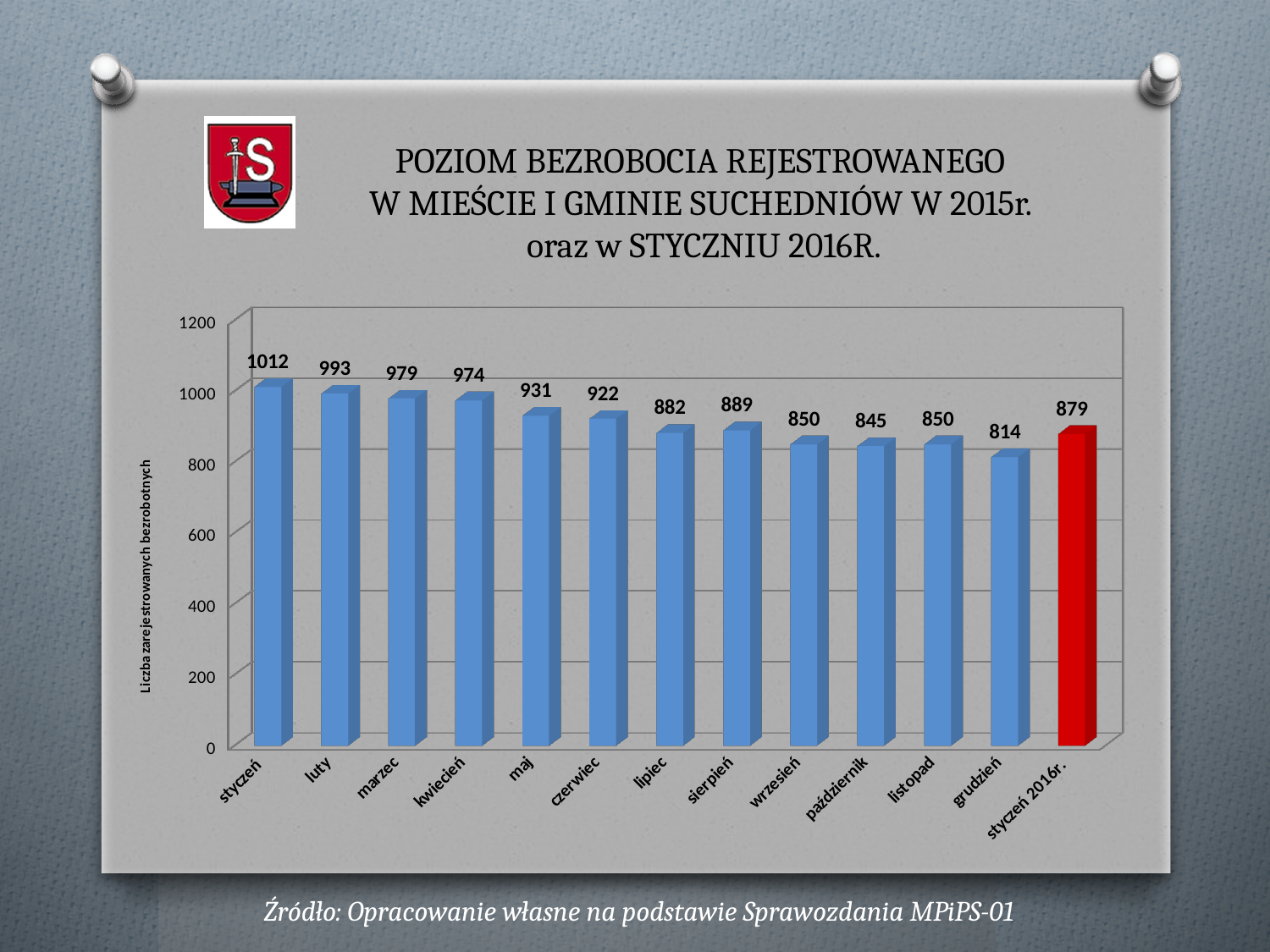
What is the value for sierpień? 889 Is the value for maj greater or less than 800? greater What is the difference between the values for styczeń and grudzień? 198 How many bars are shown in the chart? 13 Which bar is coloured red instead of blue? styczeń 2016r. Which is larger, the value for lipiec or the value for sierpień? sierpień Which category has the lowest value? grudzień Do the values generally rise or fall from styczeń to grudzień? fall What is the value for styczeń 2016r.? 879 Which category has the highest value? styczeń What is the value for styczeń? 1012 What kind of chart is shown on the slide? bar chart